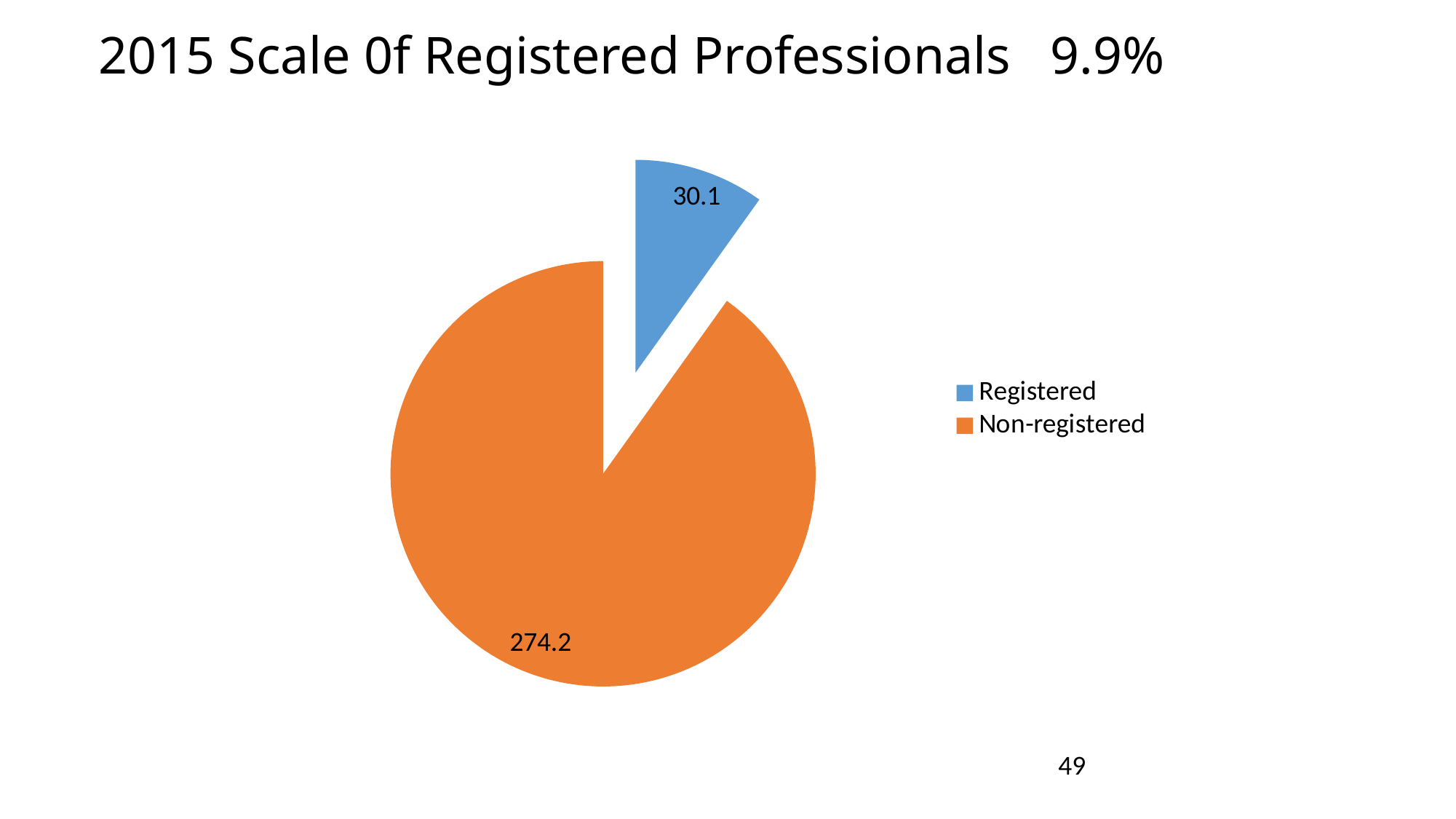
Which is larger, Registered or Non-registered? Non-registered Which category has the smallest slice of the pie? Registered What is the difference between the Non-registered and Registered values? 244.1 How many entries does the legend list? 2 What is the value for Non-registered? 274.2 What is the total of the two slices in the pie chart? 304.3 What kind of chart is shown on the slide? Pie chart What is the title of the slide? 2015 Scale 0f Registered Professionals 9.9% Which category has the largest slice of the pie? Non-registered What is the value for Registered? 30.1 How many slices does the pie chart have? 2 What colour is the Registered slice? Blue